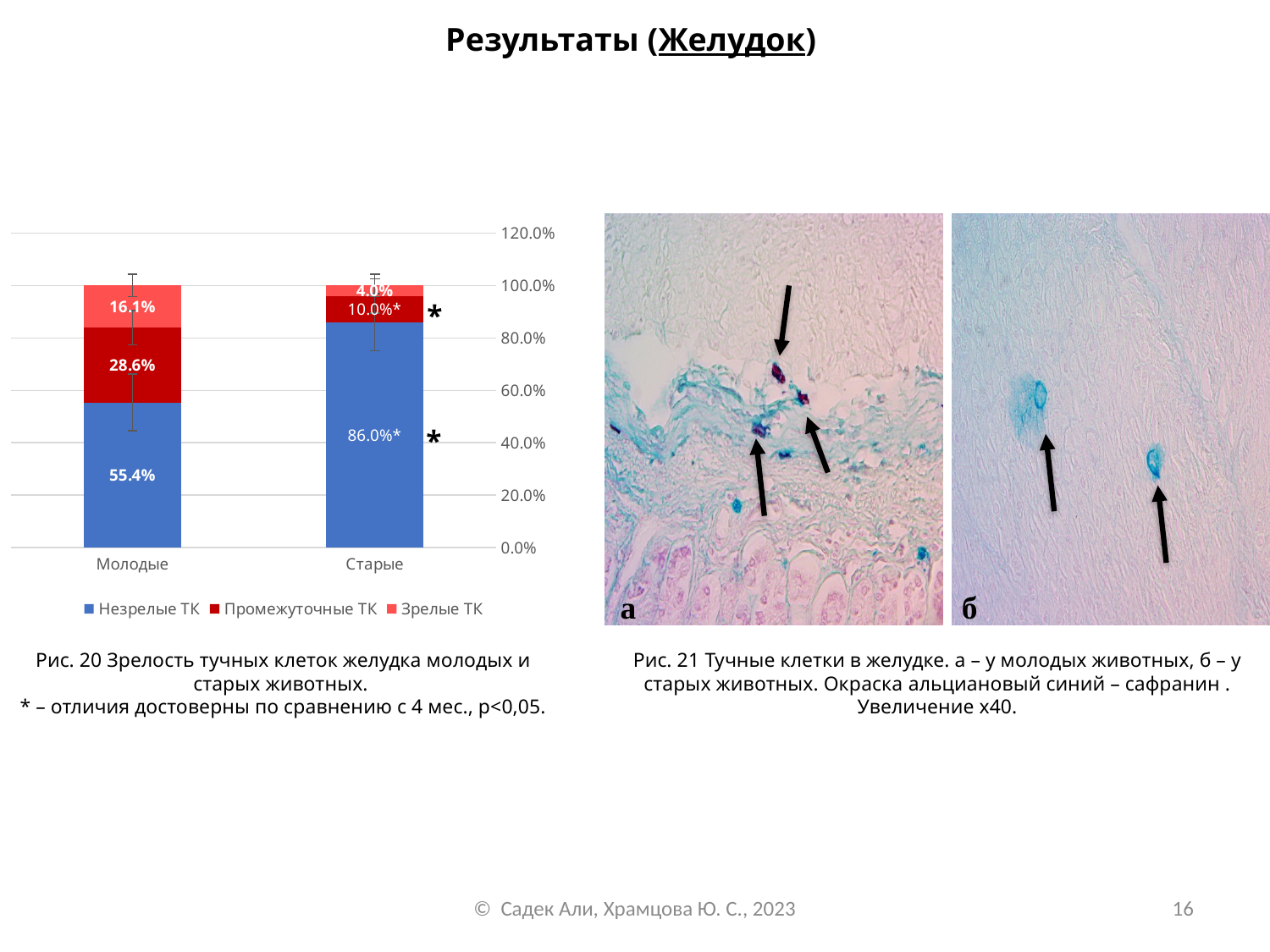
How many series does the chart legend list? 3 What is the data label for Незрелые ТК in the Старые group? 86.0%* By how many percentage points is Незрелые ТК higher in the Старые group than in the Молодые group? 30.6% What kind of chart is shown on the slide? Stacked bar chart Which series has the largest share in the Молодые bar? Незрелые ТК What is the value for Зрелые ТК in the Старые group? 4.0% How many categories are shown on the x axis of the chart? 2 What is the value for Зрелые ТК in the Молодые group? 16.1% By how many percentage points is Зрелые ТК higher in the Молодые group than in the Старые group? 12.1% Which group has the larger share of Промежуточные ТК, Молодые or Старые? Молодые What is the value for Незрелые ТК in the Молодые group? 55.4% What is the value for Промежуточные ТК in the Молодые group? 28.6%